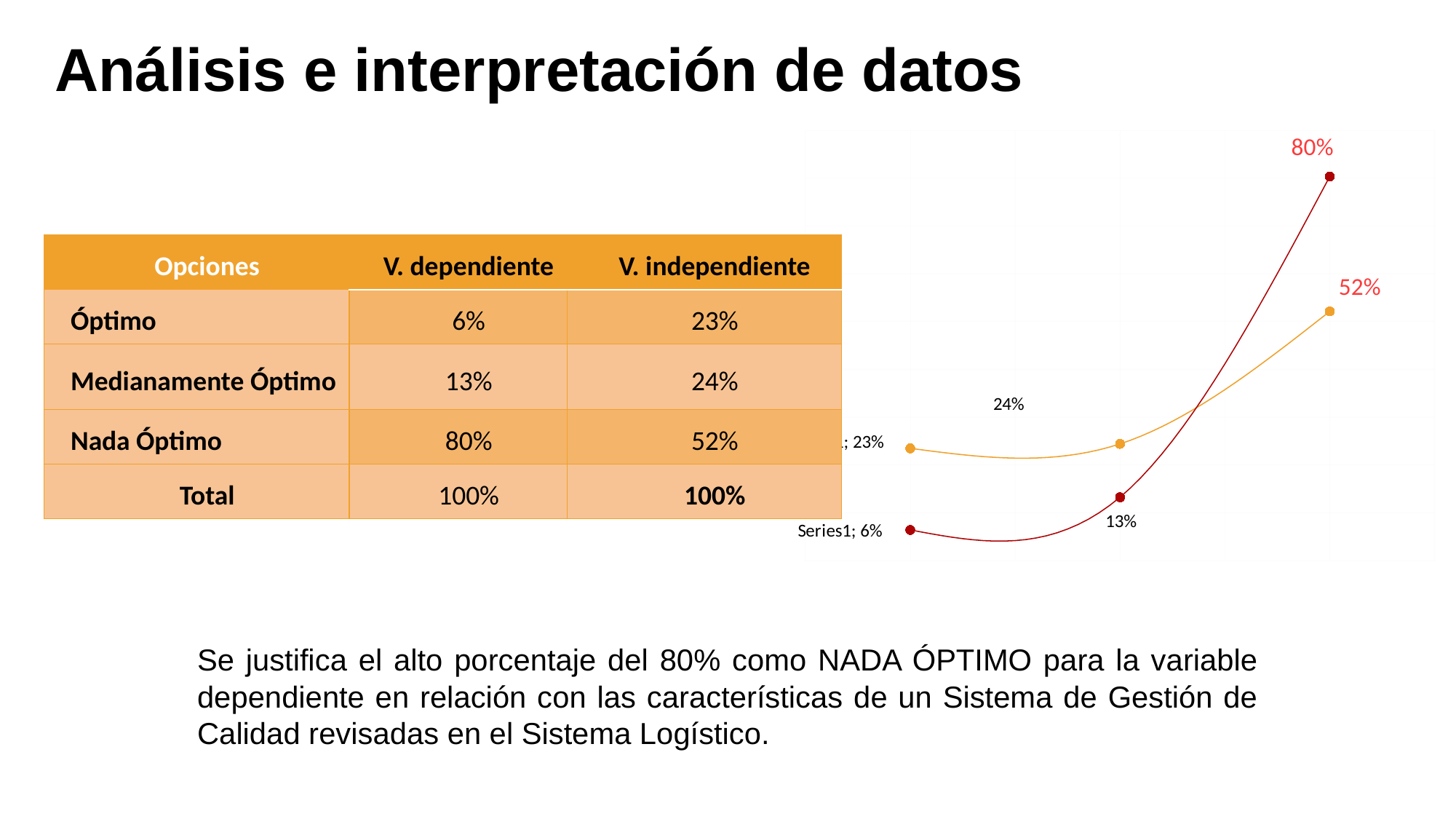
At the first data point, which line has the larger value, the red line or the orange line? The orange line What is the value of the middle point on the red line? 13% Do the values on the red line rise or fall from left to right? Rise How many lines are plotted in the chart? 2 Which colour is the line that reaches 80%? Red What is the lowest value labelled on the chart? 6% What is the highest value labelled on the chart? 80% How many data points does each line in the chart have? 3 What kind of chart is shown on the right of the slide? Line chart What is the difference between the final values of the red line (80%) and the orange line (52%)? 28 percentage points What is the value of the last point on the orange line? 52% What is the value of the first point on the orange line? 23%